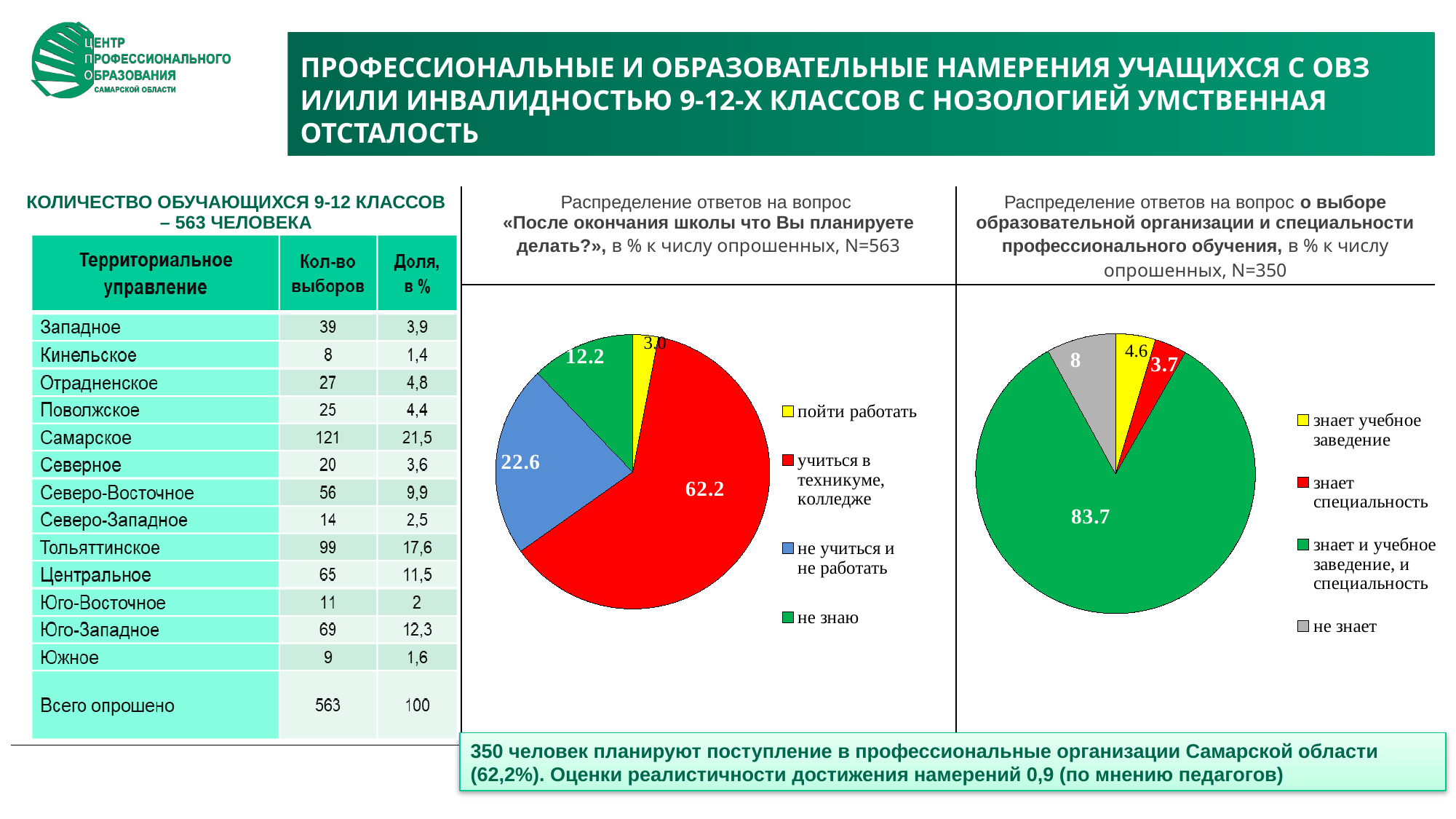
In the right pie chart (о выборе образовательной организации и специальности), what is the value for "не знает"? 8 In the right pie chart (о выборе образовательной организации и специальности), which category has the largest share? знает и учебное заведение, и специальность In the right pie chart (о выборе образовательной организации и специальности), what colour is the slice for "не знает"? grey In the left pie chart ("После окончания школы что Вы планируете делать?"), what is the value for "пойти работать"? 3.0 In the right pie chart (о выборе образовательной организации и специальности), which is larger: "знает учебное заведение" or "знает специальность"? знает учебное заведение In the left pie chart ("После окончания школы что Вы планируете делать?"), what is the difference between "не учиться и не работать" and "не знаю"? 10.4 How many categories does the legend of the left pie chart ("После окончания школы что Вы планируете делать?") list? 4 In the left pie chart ("После окончания школы что Вы планируете делать?"), which category has the smallest share? пойти работать In the left pie chart ("После окончания школы что Вы планируете делать?"), what is the value for "учиться в техникуме, колледже"? 62.2 In the left pie chart ("После окончания школы что Вы планируете делать?"), what is the value for "не учиться и не работать"? 22.6 In the right pie chart (о выборе образовательной организации и специальности), what is the value for "знает и учебное заведение, и специальность"? 83.7 What type of chart is the right chart (о выборе образовательной организации и специальности)? pie chart